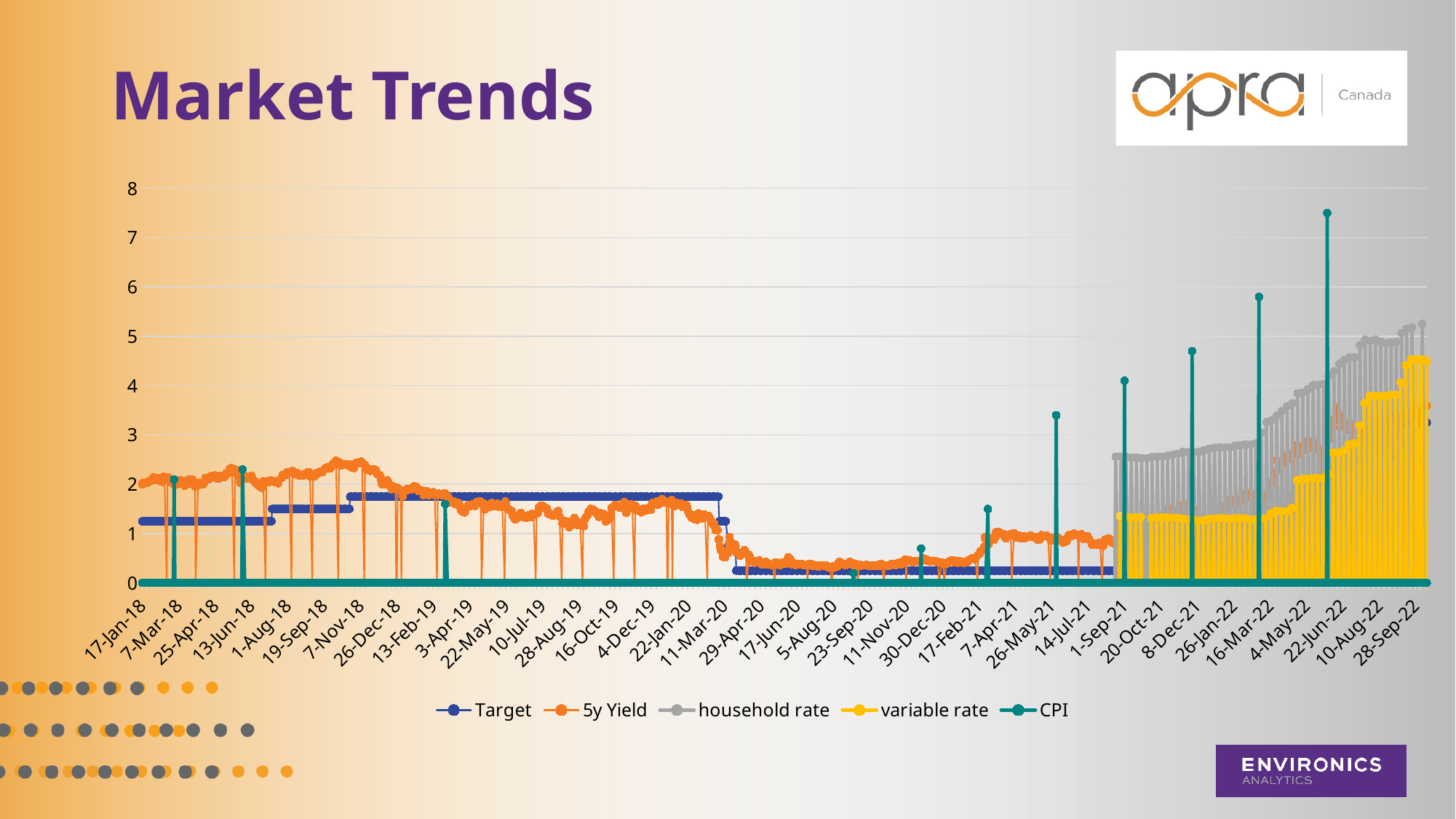
Is the Target value at 17-Jan-18 greater or less than 2? less What is the title of the slide containing the chart? Market Trends How many series does the legend list? 5 Which series reaches the highest value anywhere on the chart? CPI Is the 5y Yield around 17-Jun-20 greater or less than 1? less What are the series names listed in the legend? Target, 5y Yield, household rate, variable rate, CPI What kind of chart is shown on the slide? line chart Is the household rate around 20-Oct-21 greater or less than 2? greater Does the variable rate rise or fall between 1-Sep-21 and 28-Sep-22? rise Does the 5y Yield rise or fall between 7-Nov-18 and 29-Apr-20? fall At the right end of the chart (around 28-Sep-22), which is higher, the household rate or the variable rate? household rate